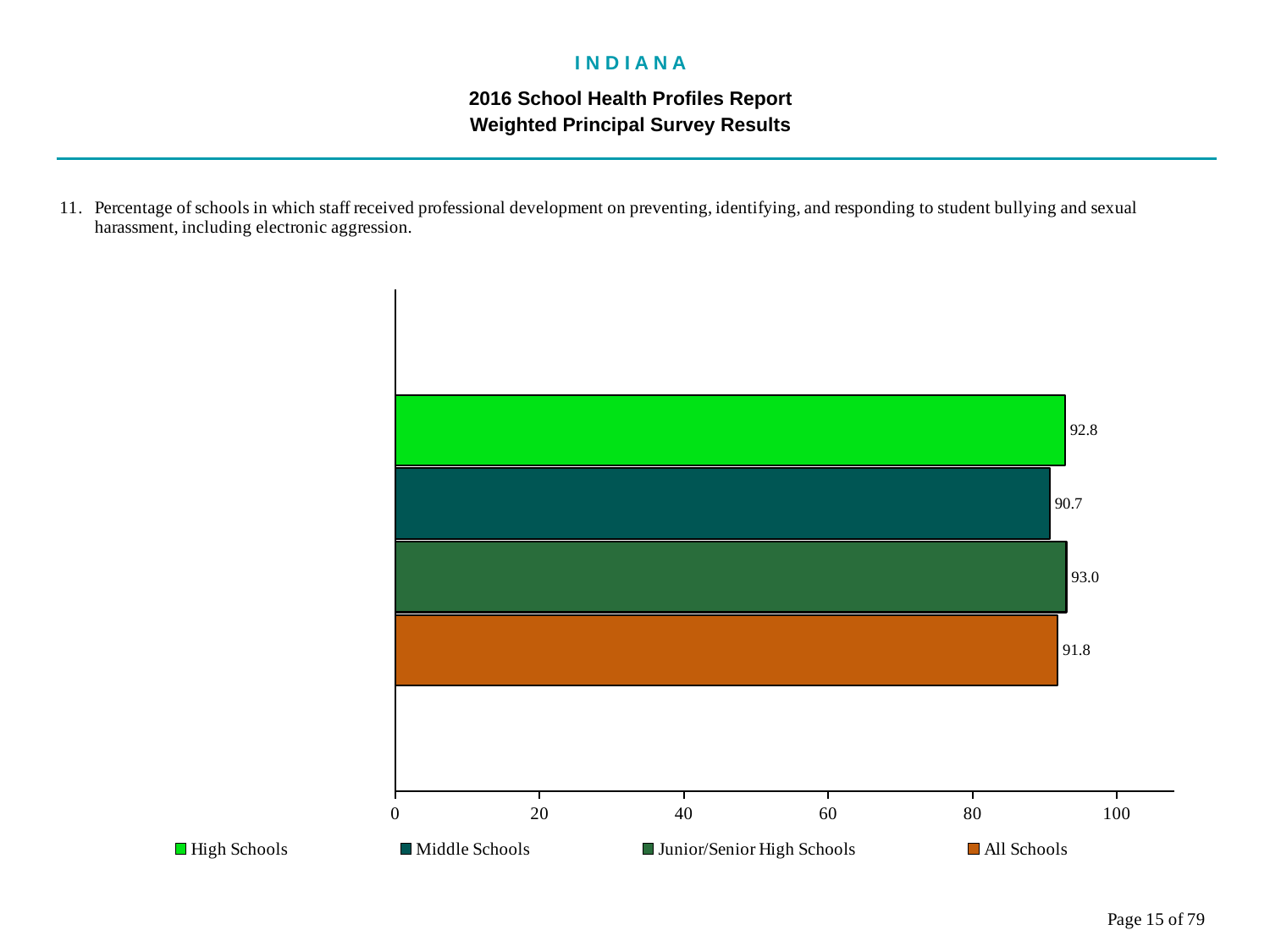
What is the difference between the values for Junior/Senior High Schools and All Schools? 1.2 What is the value for Junior/Senior High Schools? 93.0 What is the value for High Schools? 92.8 Which is larger, the value for High Schools or the value for All Schools? High Schools What is the difference between the values for High Schools and Middle Schools? 2.1 What kind of chart is shown on the slide? bar chart What is the value for Middle Schools? 90.7 What is the value for All Schools? 91.8 Which school type has the lowest value? Middle Schools Which school type has the highest value? Junior/Senior High Schools How many series does the legend list? 4 Is the value for Middle Schools greater or less than 80? greater